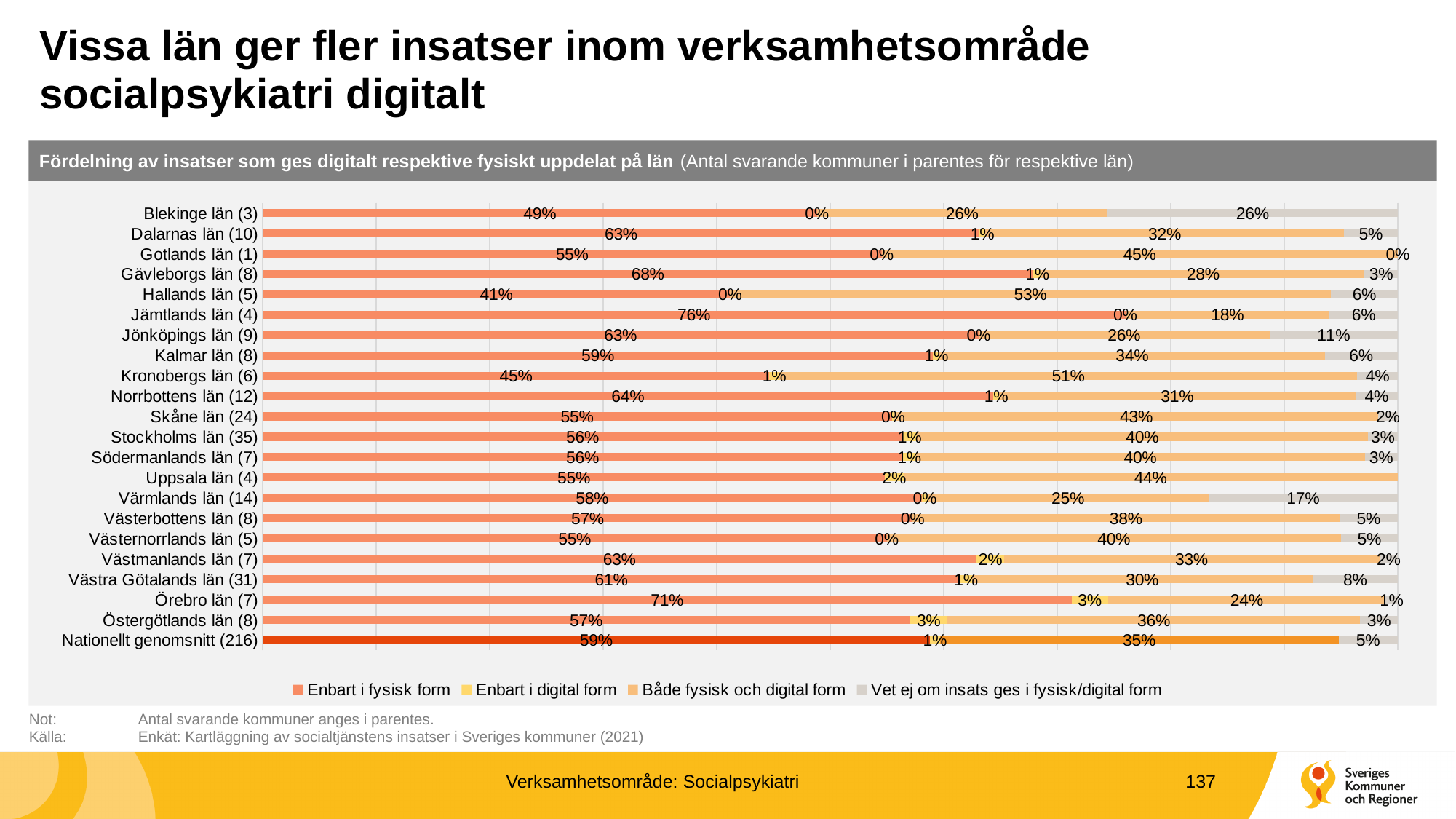
What is the difference in 'Enbart i fysisk form' between Jämtlands län (4) and Hallands län (5)? 35 percentage points What is the value of 'Vet ej om insats ges i fysisk/digital form' for Värmlands län (14)? 17% Which category has the lowest value for 'Enbart i fysisk form'? Hallands län (5) Which category has the highest value for 'Enbart i fysisk form'? Jämtlands län (4) How many series does the legend list? 4 What is the value of 'Enbart i fysisk form' for Jämtlands län (4)? 76% How many categories (rows) are plotted in the chart? 22 What is the value of 'Både fysisk och digital form' for Hallands län (5)? 53% Which category has the highest value for 'Vet ej om insats ges i fysisk/digital form'? Blekinge län (3) What is the value of 'Enbart i fysisk form' for Nationellt genomsnitt (216)? 59% What kind of chart is shown on the slide? Stacked bar chart Which has a larger 'Enbart i fysisk form' value, Gävleborgs län (8) or Örebro län (7)? Örebro län (7)